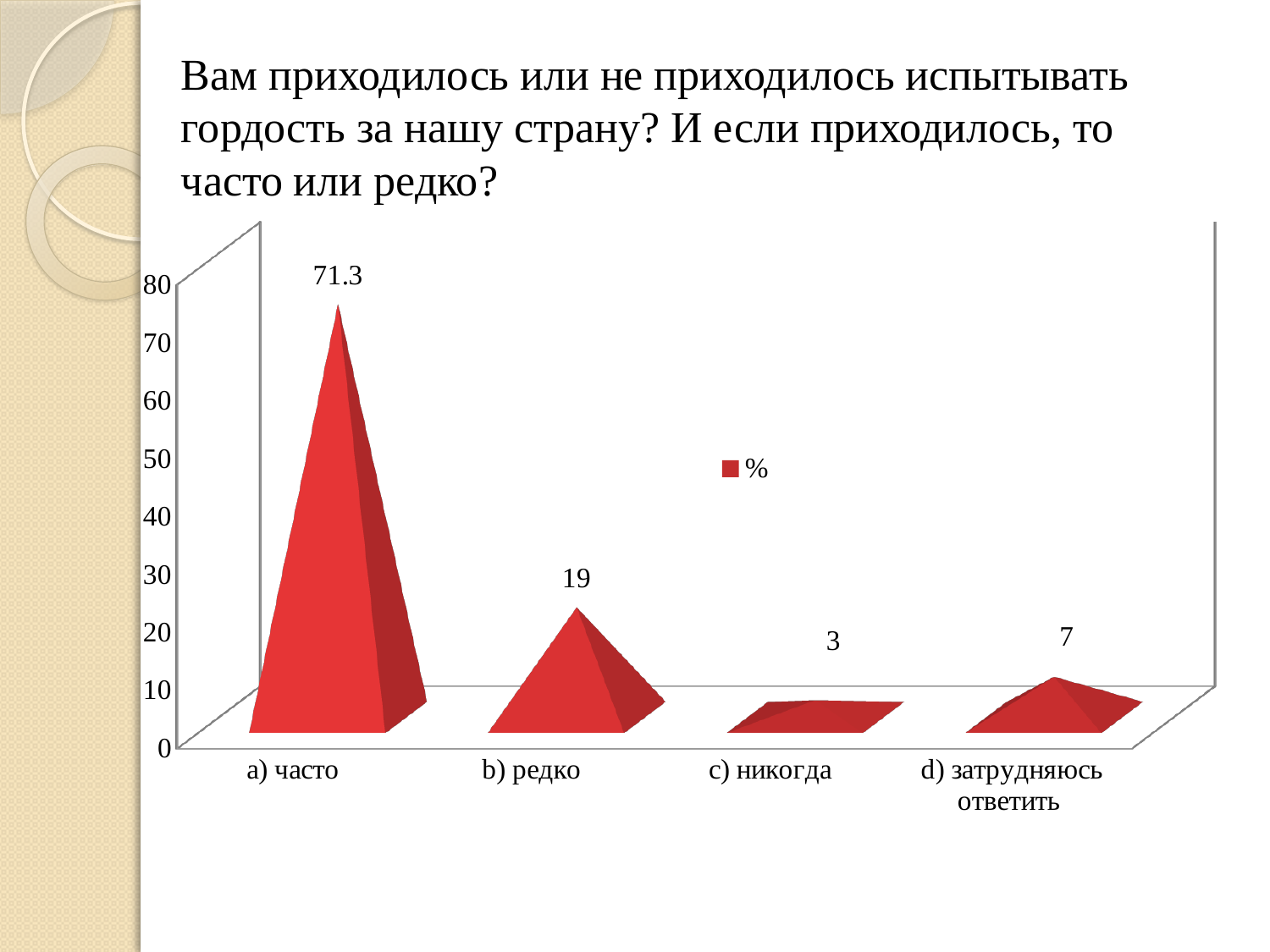
Which is larger, the value for "d) затрудняюсь ответить" or the value for "c) никогда"? d) затрудняюсь ответить What is the value for "c) никогда"? 3 What is the value for "a) часто"? 71.3 Is the value for "b) редко" greater or less than 30? less How many series does the legend list? 1 What kind of chart is shown on the slide? bar chart How many categories are shown on the x axis? 4 What is the value for "d) затрудняюсь ответить"? 7 What is the value for "b) редко"? 19 Which category has the highest value? a) часто What is the difference between the values for "a) часто" and "b) редко"? 52.3 Which category has the lowest value? c) никогда